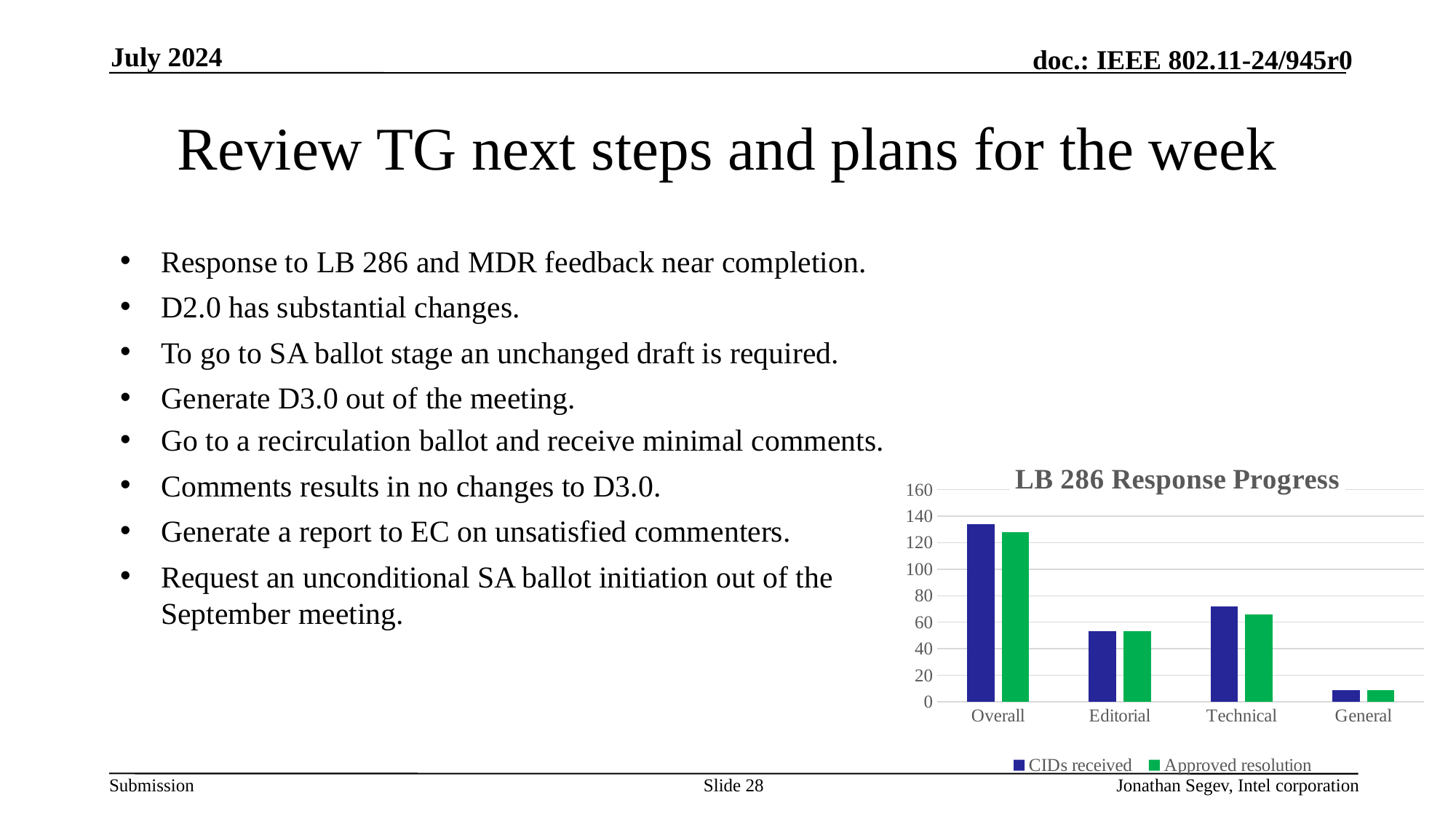
Which series is shown in green in the chart legend? Approved resolution Is the value for CIDs received in the Overall category greater or less than 120? greater What kind of chart is shown on the slide? bar chart Is the value for CIDs received in the Editorial category greater or less than 60? less How many series does the chart legend list? 2 What is the title of the chart? LB 286 Response Progress Which category has the lowest value for Approved resolution? General Is the value for CIDs received in the Technical category greater or less than 60? greater Which category has the highest value for CIDs received? Overall Which is larger for CIDs received: Technical or Editorial? Technical How many categories are shown on the x axis of the chart? 4